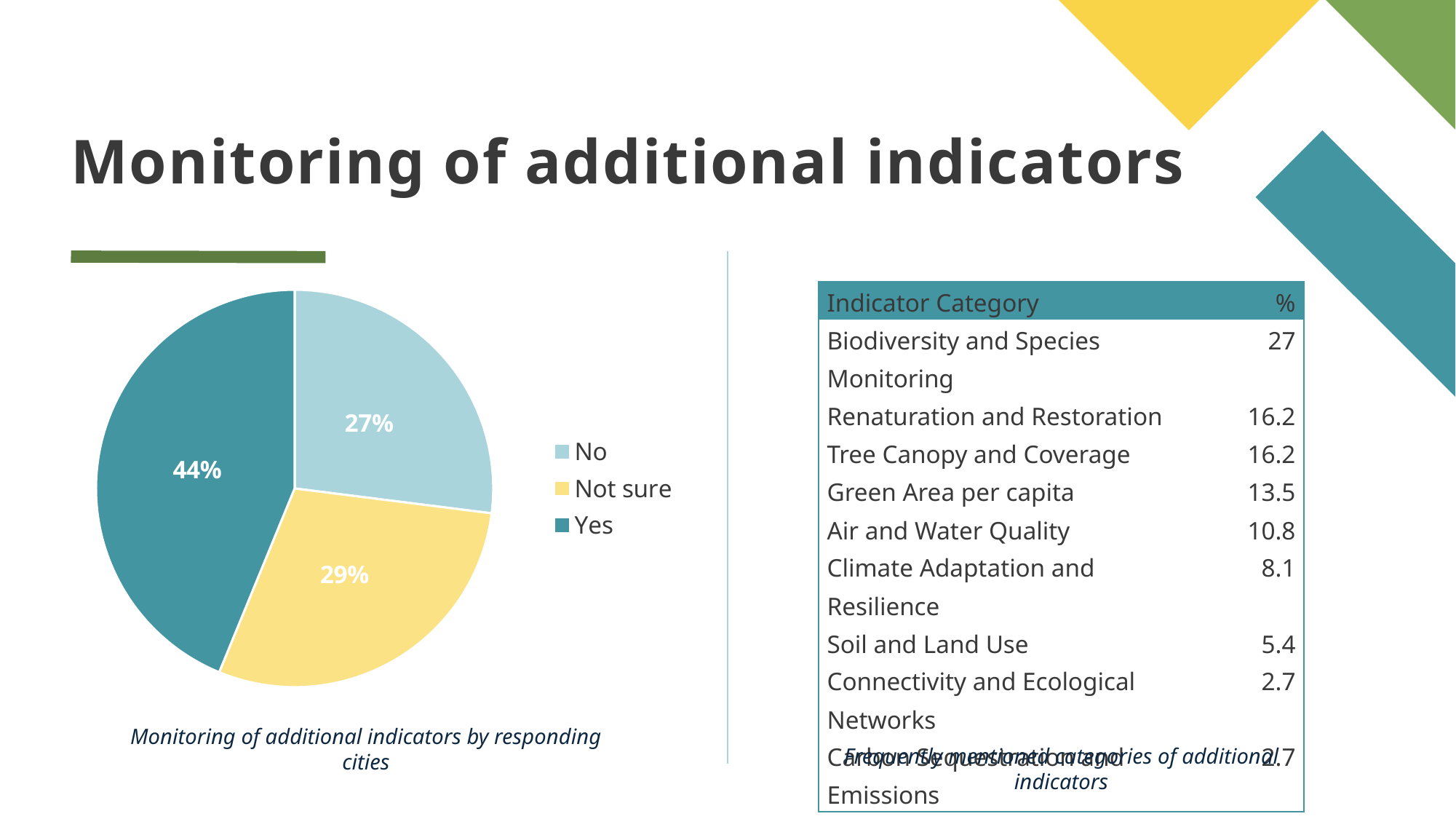
How many entries does the pie chart's legend list? 3 What colour is the "Not sure" slice in the pie chart? yellow What percentage of responding cities answered "No" in the pie chart? 27% Which category has the largest slice in the pie chart? Yes What is the difference in percentage points between the "Not sure" and "No" slices? 2 How many slices does the pie chart have? 3 What percentage of responding cities answered "Yes" in the pie chart? 44% Which is larger in the pie chart, the "Yes" slice or the "Not sure" slice? Yes What kind of chart is shown on the slide? pie chart What is the difference in percentage points between the "Yes" and "No" slices? 17 What percentage of responding cities answered "Not sure" in the pie chart? 29% Which category has the smallest slice in the pie chart? No